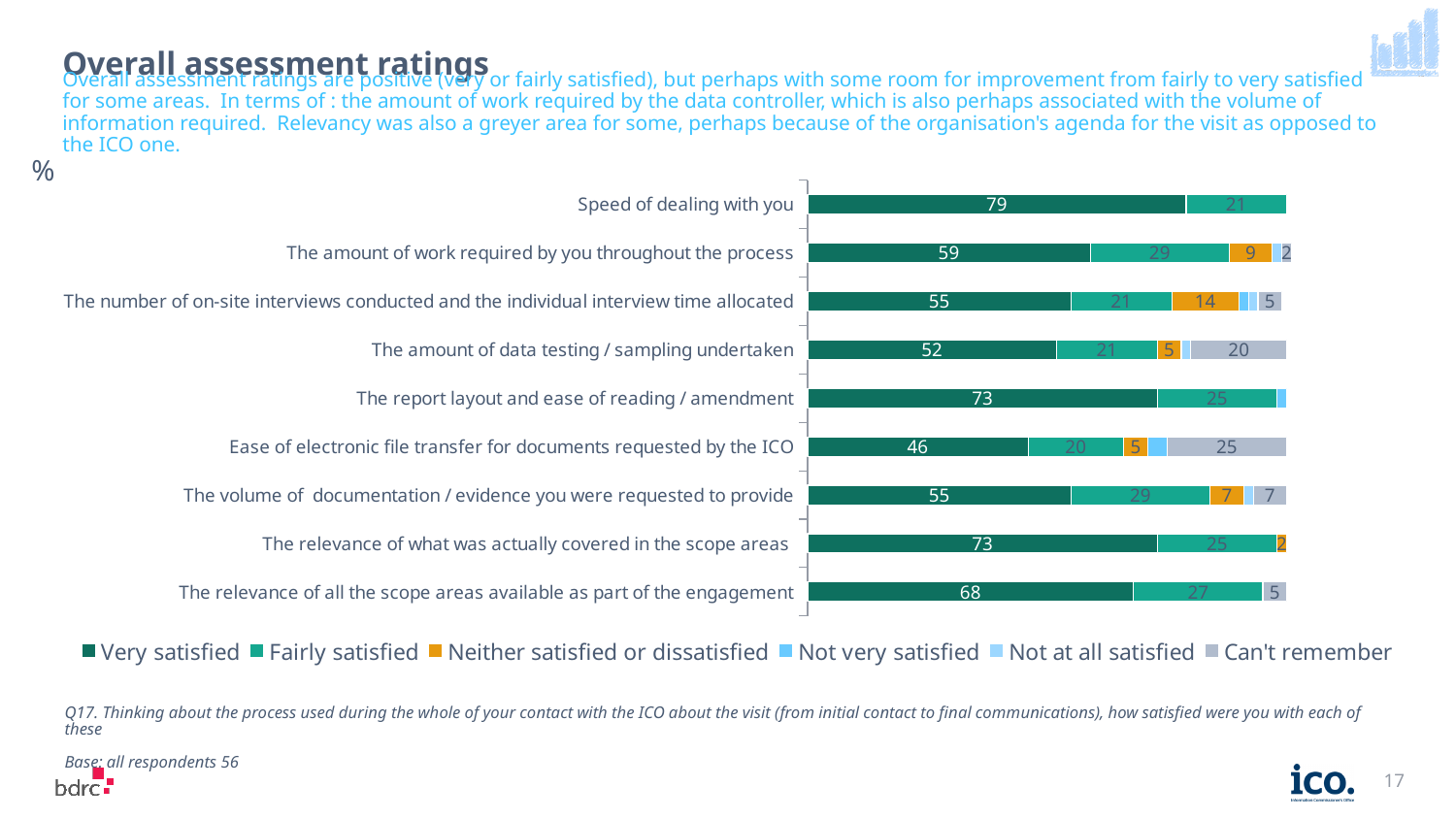
What percentage of respondents were very satisfied with the speed of dealing with you? 79 What is the total of the 'Speed of dealing with you' bar? 100 How many series does the legend list? 6 What is the 'Fairly satisfied' value for 'The amount of work required by you throughout the process'? 29 What is the 'Can't remember' value for 'Ease of electronic file transfer for documents requested by the ICO'? 25 Which category has the lowest 'Very satisfied' value? Ease of electronic file transfer for documents requested by the ICO Which category has the highest 'Very satisfied' value? Speed of dealing with you What is the 'Neither satisfied or dissatisfied' value for 'The number of on-site interviews conducted and the individual interview time allocated'? 14 What kind of chart is shown on the slide? Stacked bar chart Which has a higher 'Very satisfied' value: 'The amount of data testing / sampling undertaken' or 'The relevance of all the scope areas available as part of the engagement'? The relevance of all the scope areas available as part of the engagement What is the difference between the 'Very satisfied' values for 'Speed of dealing with you' and 'Ease of electronic file transfer for documents requested by the ICO'? 33 How many categories are shown on the chart? 9